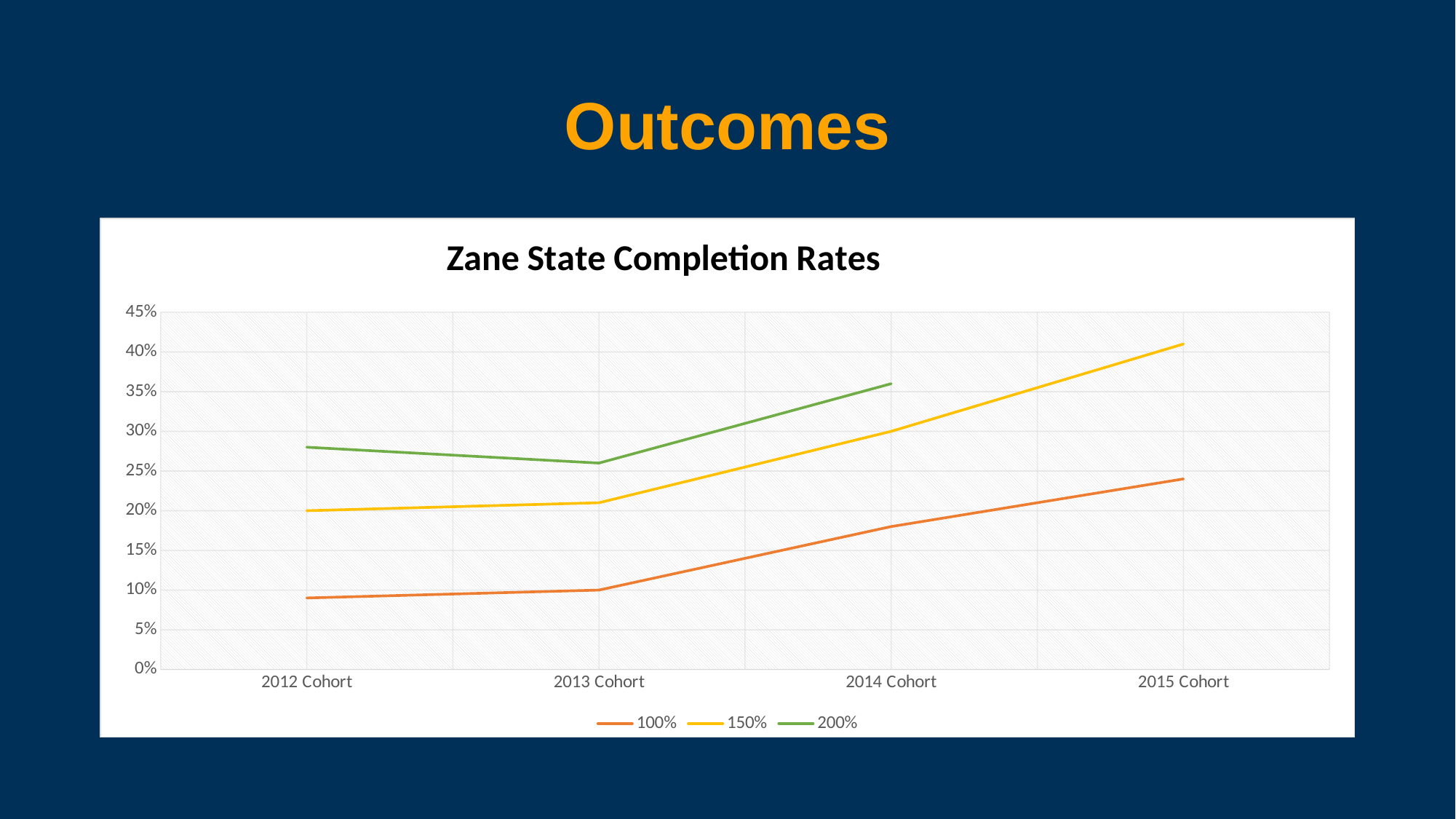
How many series does the legend list? 3 What is the title of the chart? Zane State Completion Rates Is the 200% completion rate for the 2014 Cohort greater or less than 40%? less What type of chart is shown on the slide? Line chart Does the 100% series rise or fall from the 2012 Cohort to the 2015 Cohort? Rise What is the 100% completion rate for the 2013 Cohort? 10% What is the 150% completion rate for the 2012 Cohort? 20% What is the 150% completion rate for the 2014 Cohort? 30% Which series has the highest value for the 2014 Cohort? 200% How many cohorts are shown on the x axis? 4 Is the 150% completion rate for the 2015 Cohort greater or less than 35%? greater Is the 100% completion rate for the 2015 Cohort greater or less than 20%? greater